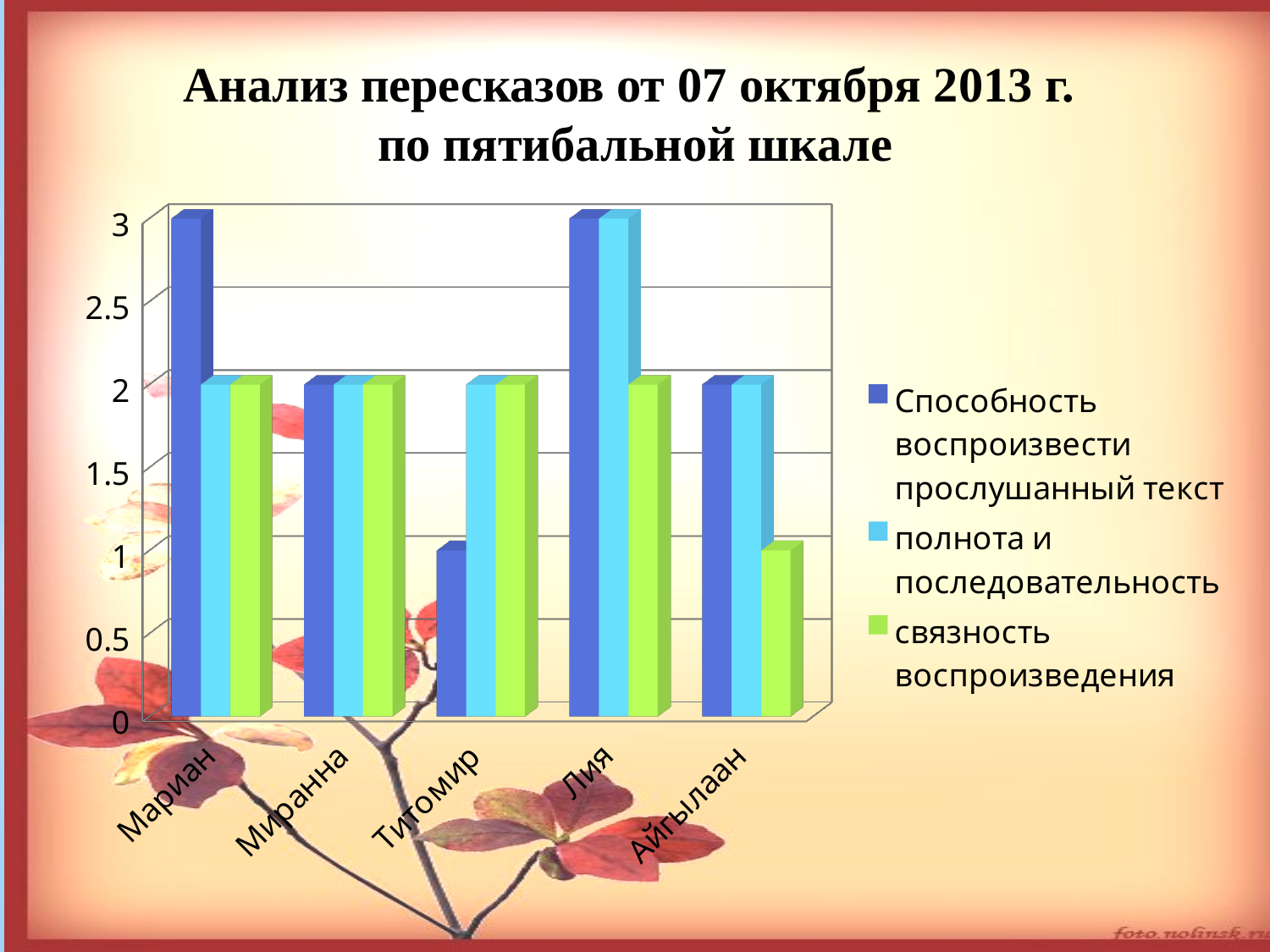
How many students (categories) are shown on the x axis of the chart? 5 What is the value of 'полнота и последовательность' for Лия? 3 What is the value of 'Способность воспроизвести прослушанный текст' for Мариан? 3 Which student has the highest value for 'полнота и последовательность'? Лия How many series does the chart legend list? 3 What is the value of 'связность воспроизведения' for Айгылаан? 1 Is the 'связность воспроизведения' value for Лия larger or smaller than that for Айгылаан? larger What is the value of 'Способность воспроизвести прослушанный текст' for Титомир? 1 Which student has the lowest value for 'Способность воспроизвести прослушанный текст'? Титомир What is the title of the chart on the slide? Анализ пересказов от 07 октября 2013 г. по пятибальной шкале What kind of chart is shown on the slide? bar chart What is the difference between the 'Способность воспроизвести прослушанный текст' values for Мариан and Титомир? 2